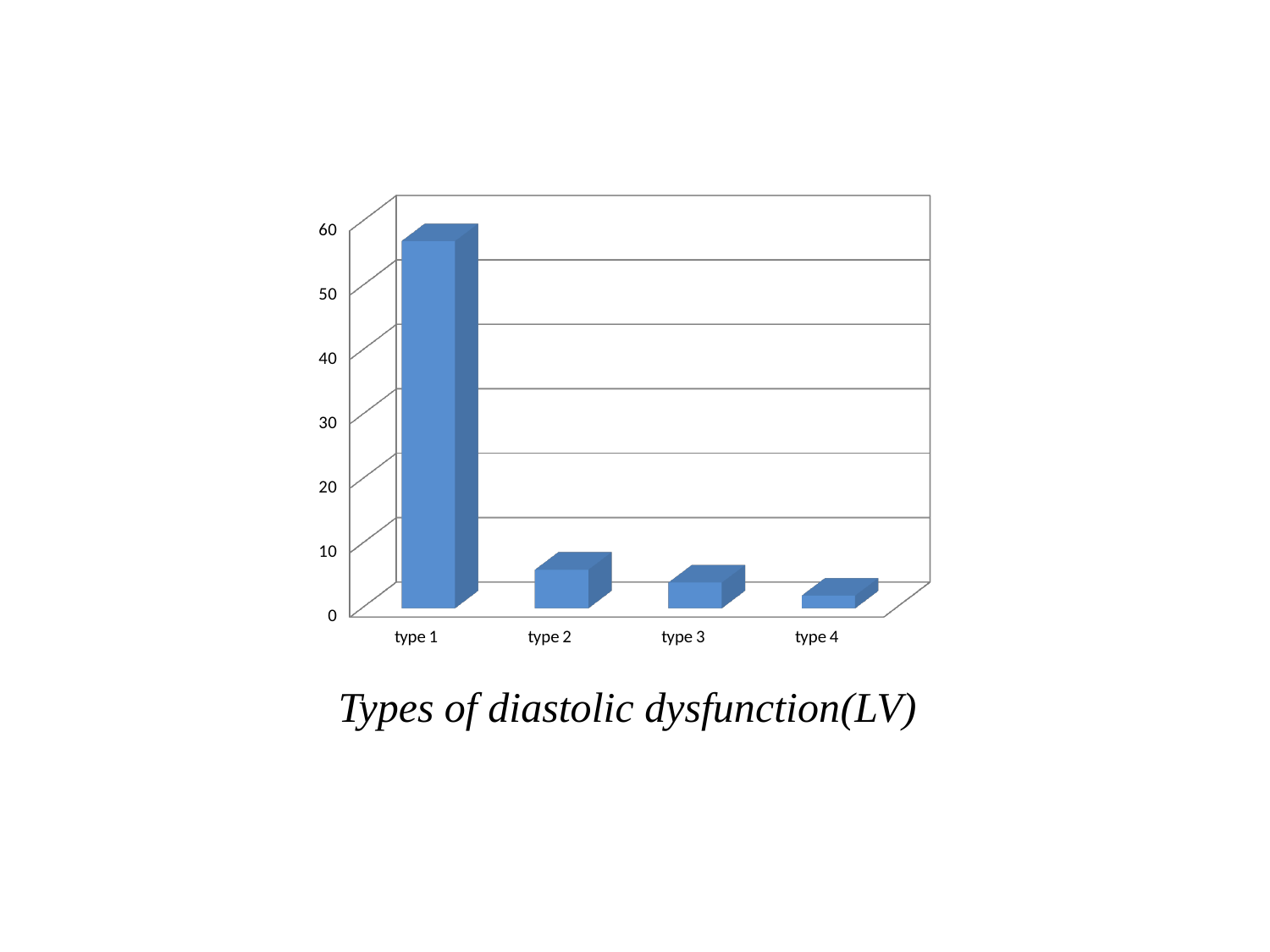
Which category has the lowest value in the chart? type 4 Which category has the highest value in the chart? type 1 Is the value for type 4 greater or less than 10? less Is the value for type 3 greater or less than 10? less Is the value for type 2 greater or less than 10? less What kind of chart is shown on the slide? bar chart Which is larger, the value for type 1 or the value for type 2? type 1 How many categories are shown on the x axis of the chart? 4 What is the caption written below the chart? Types of diastolic dysfunction(LV) Which is larger, the value for type 2 or the value for type 4? type 2 Do the values rise or fall from type 1 to type 4 along the x axis? fall